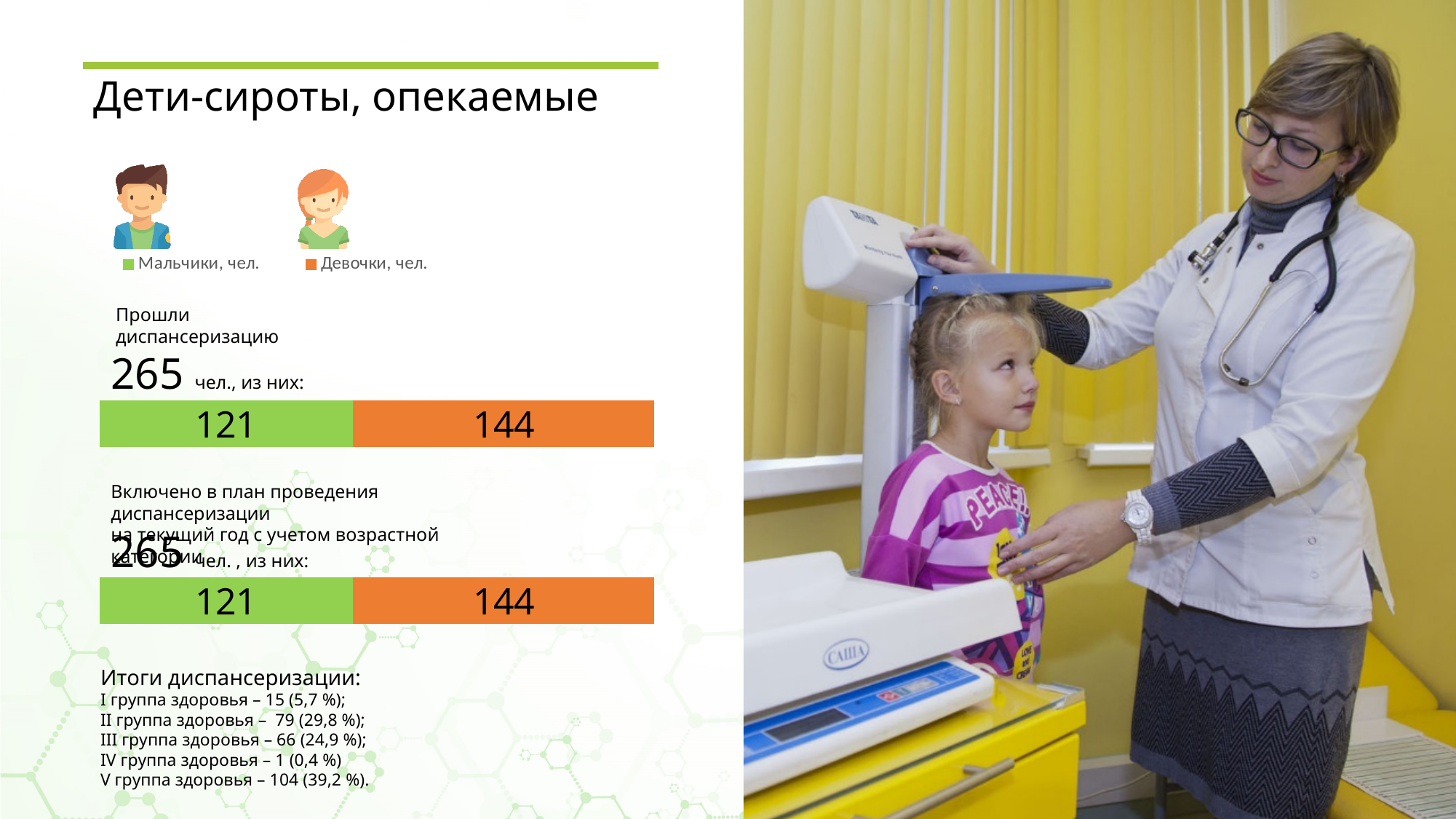
How many series does the legend list for the bar charts on the slide? 2 What kind of chart is used to show the Мальчики and Девочки values on the slide? Bar chart In the upper bar chart (Прошли диспансеризацию), what is the difference between the Девочки and Мальчики values? 23 In the upper bar chart (Прошли диспансеризацию), what is the value for Мальчики, чел.? 121 In the lower bar chart (Включено в план проведения диспансеризации), what is the total of the stacked bar? 265 In the lower bar chart (Включено в план проведения диспансеризации), what is the value for Мальчики, чел.? 121 In the upper bar chart (Прошли диспансеризацию), which series has the larger value, Мальчики or Девочки? Девочки In the lower bar chart (Включено в план проведения диспансеризации), what is the difference between the Девочки and Мальчики values? 23 In the upper bar chart (Прошли диспансеризацию), what is the value for Девочки, чел.? 144 In the legend of the bar charts, which colour represents Девочки, чел.? Orange In the upper bar chart (Прошли диспансеризацию), what is the total of the stacked bar? 265 In the lower bar chart (Включено в план проведения диспансеризации), what is the value for Девочки, чел.? 144